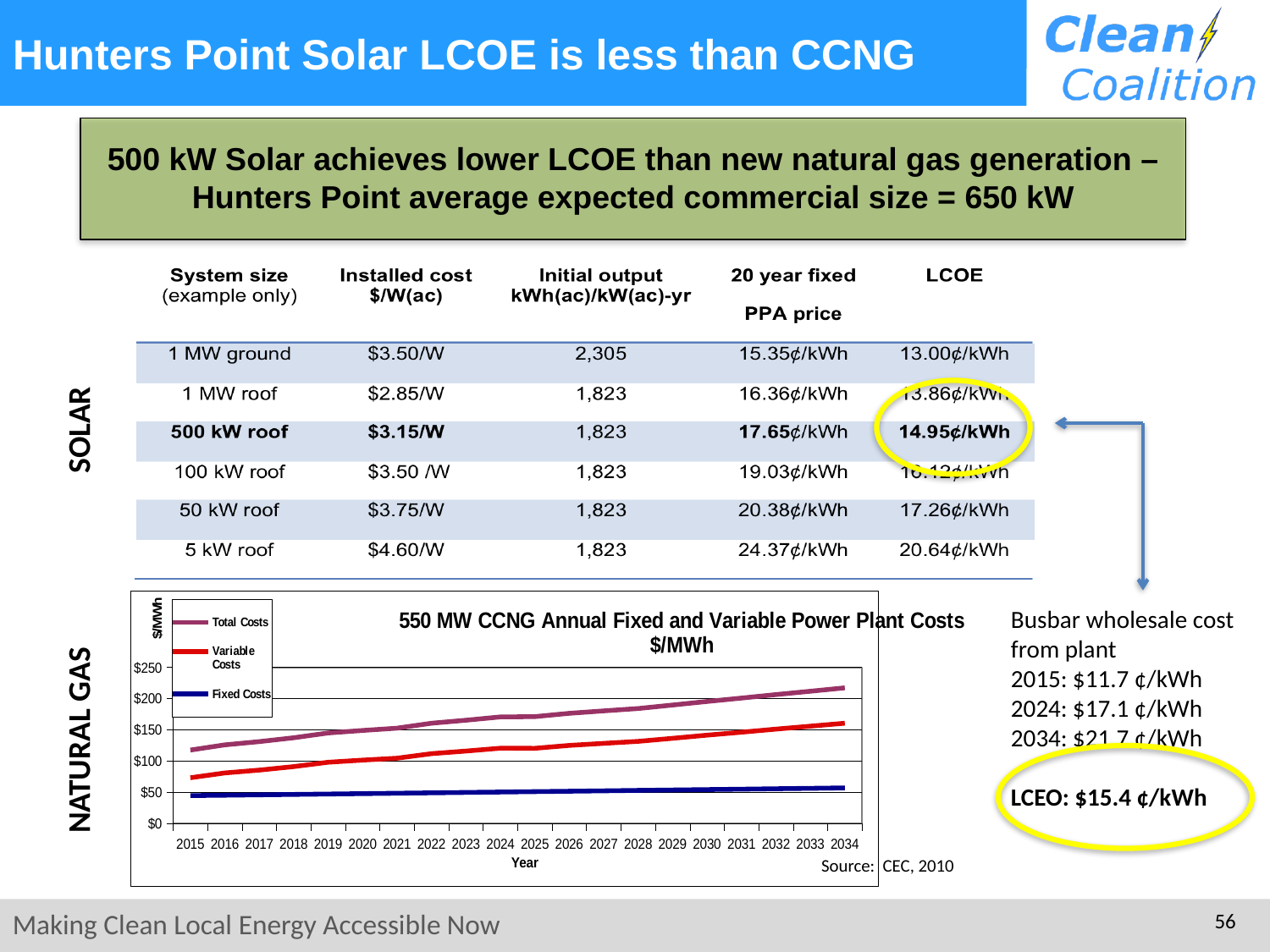
Do the Total Costs in the line chart rise or fall from 2015 to 2034? rise How many years are shown along the x axis of the line chart? 20 Is the Variable Costs value for 2015 in the line chart greater or less than $100? less What is the title of the line chart? 550 MW CCNG Annual Fixed and Variable Power Plant Costs $/MWh How many series does the legend of the line chart list? 3 In the line chart, which series has the lowest values across all years? Fixed Costs What kind of chart is shown in the Natural Gas section of the slide? line chart Is the Total Costs value for 2034 in the line chart greater or less than $200? greater Which year is the first on the x axis of the line chart? 2015 Is the Fixed Costs value for 2034 in the line chart greater or less than $100? less Which year is the last on the x axis of the line chart? 2034 What are the three series named in the legend of the line chart? Total Costs, Variable Costs, Fixed Costs